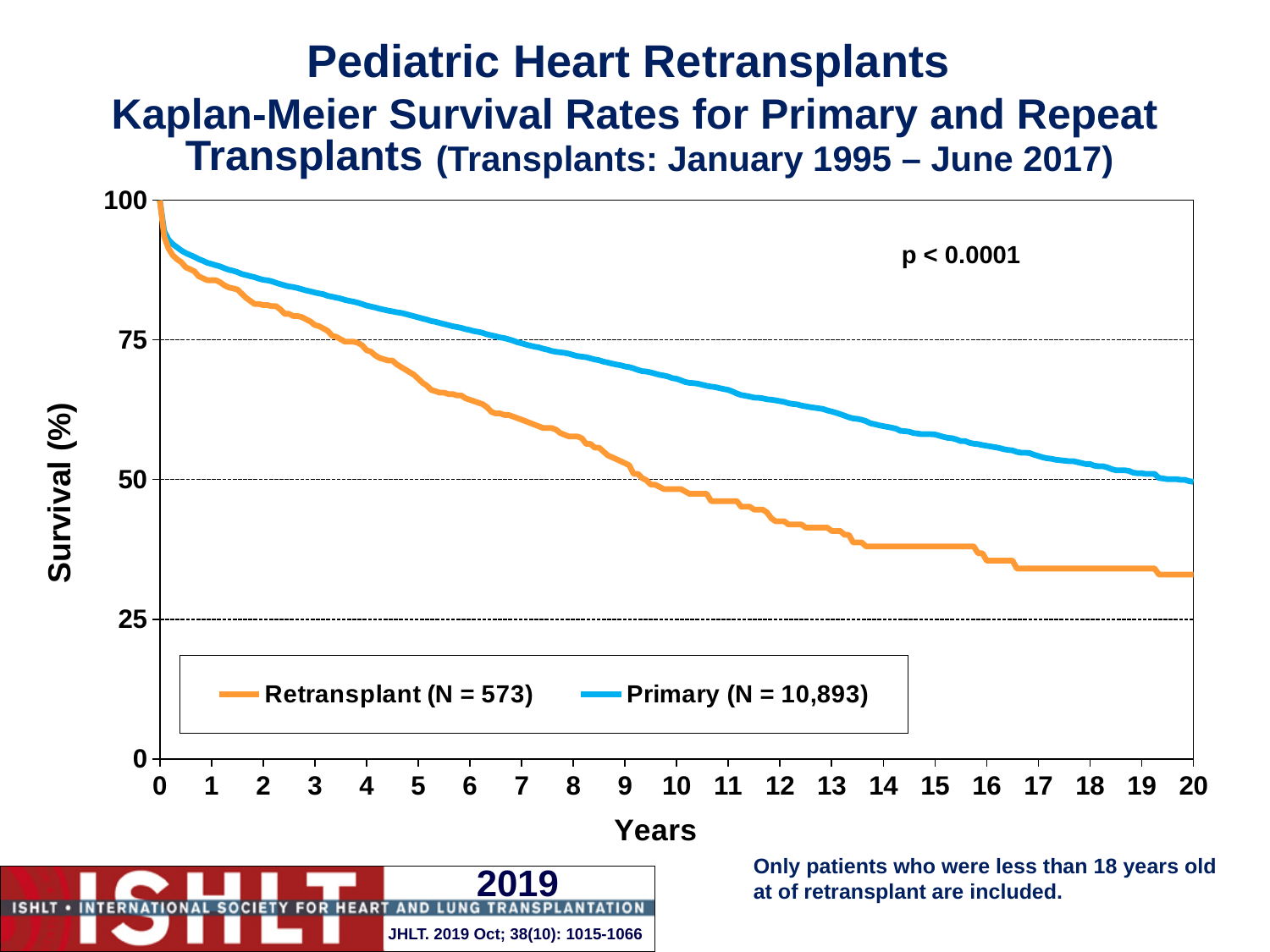
Is the survival value for the Retransplant series at 15 years greater or less than 50? less Is the survival value for the Primary series at 5 years greater or less than 75? greater Do the survival values for the Retransplant series rise or fall as years increase? fall What kind of chart is shown on the slide? line chart At 10 years, which series has the higher survival, Retransplant or Primary? Primary What is the N value shown in the legend for the Retransplant series? 573 Is the survival value for the Retransplant series at 5 years greater or less than 75? less Do the survival values for the Primary series rise or fall as years increase? fall How many series does the legend list? 2 What p-value is printed on the chart? p < 0.0001